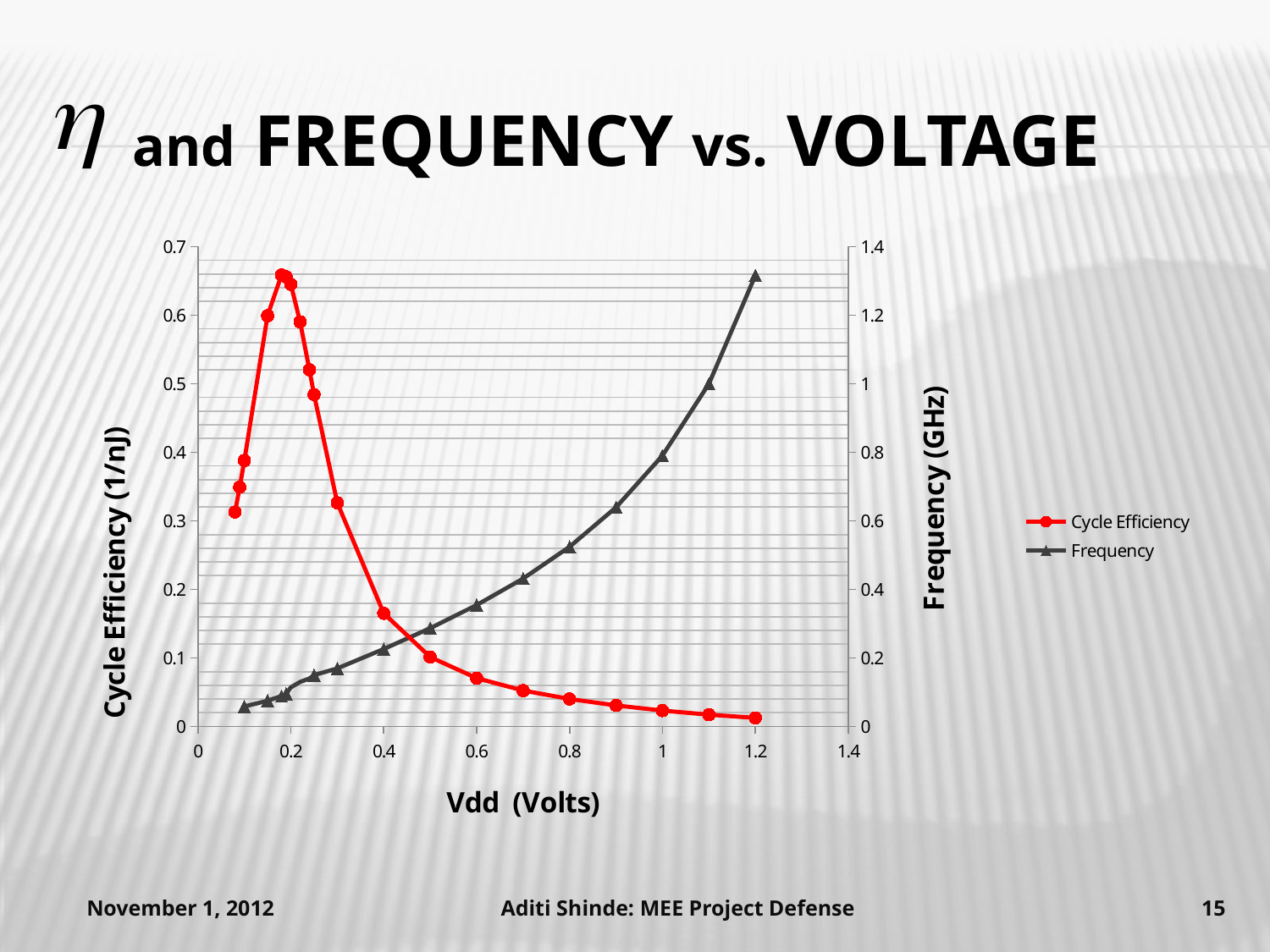
Is the Cycle Efficiency value at Vdd 0.6 volts greater or less than 0.1? less Does the Frequency series rise or fall as Vdd increases? rises Is the Frequency value at Vdd 1.2 volts greater or less than 1.2 GHz? greater Is the Frequency value at Vdd 0.8 volts greater or less than 0.6 GHz? less Does the Cycle Efficiency series rise or fall as Vdd increases from 0.4 to 1.2 volts? falls What kind of chart is shown on the slide? line chart Which series reaches its maximum at Vdd 1.2 volts? Frequency How many series does the legend list? 2 What are the two series named in the legend? Cycle Efficiency and Frequency What is the title of the x axis? Vdd (Volts)